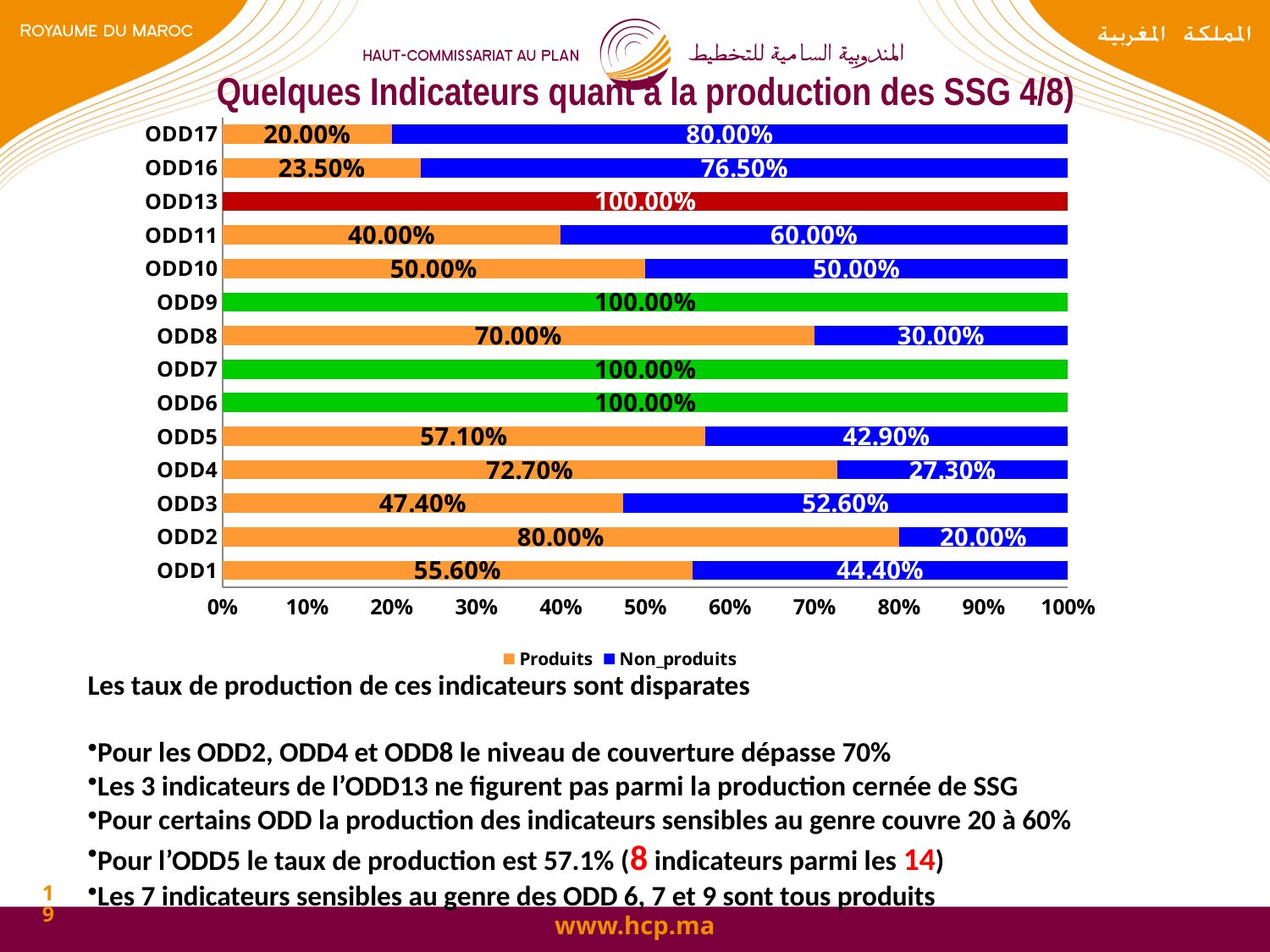
What is the Non_produits value for ODD16? 76.50% What is the total of the stacked bar for ODD10? 100.00% What kind of chart is shown on the slide? Stacked bar chart Which is larger for ODD3: the Produits value or the Non_produits value? Non_produits What is the Produits value for ODD2? 80.00% What is the Non_produits value for ODD11? 60.00% How many series does the legend list? 2 Which ODD has the lowest Produits share among the bars with an orange segment? ODD17 What is the Produits value for ODD5? 57.10% Is the Produits value for ODD4 greater or less than 70%? greater What is the difference between the Produits and Non_produits values for ODD8? 40.00% How many ODD categories are shown on the chart? 14